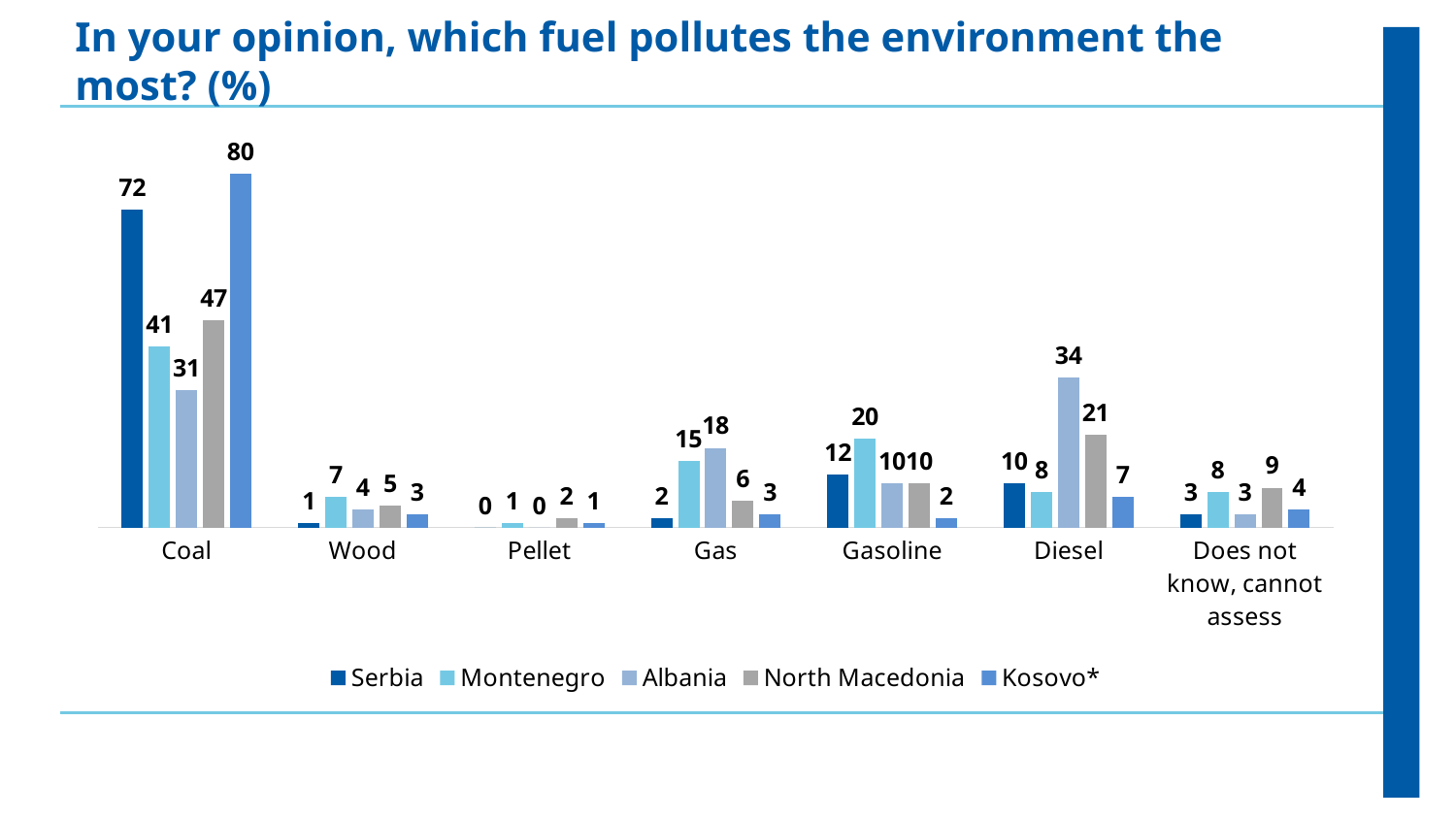
Which series is shown in the darkest blue colour in the legend? Serbia What is the value for Albania in the Diesel category? 34 What percentage of respondents in Kosovo* named coal as the fuel that pollutes the environment the most? 80 What is the difference between the Kosovo* and Serbia values for Coal? 8 Which country has the lowest value for Gasoline? Kosovo* What is the value for Montenegro in the Gasoline category? 20 What type of chart is shown on the slide? Bar chart How many series does the legend list? 5 Which is larger: the Albania value for Gas or the Montenegro value for Gas? Albania Which country has the highest value for Coal? Kosovo* What is the difference between the North Macedonia and Serbia values for Diesel? 11 How many fuel categories are shown on the x axis? 7